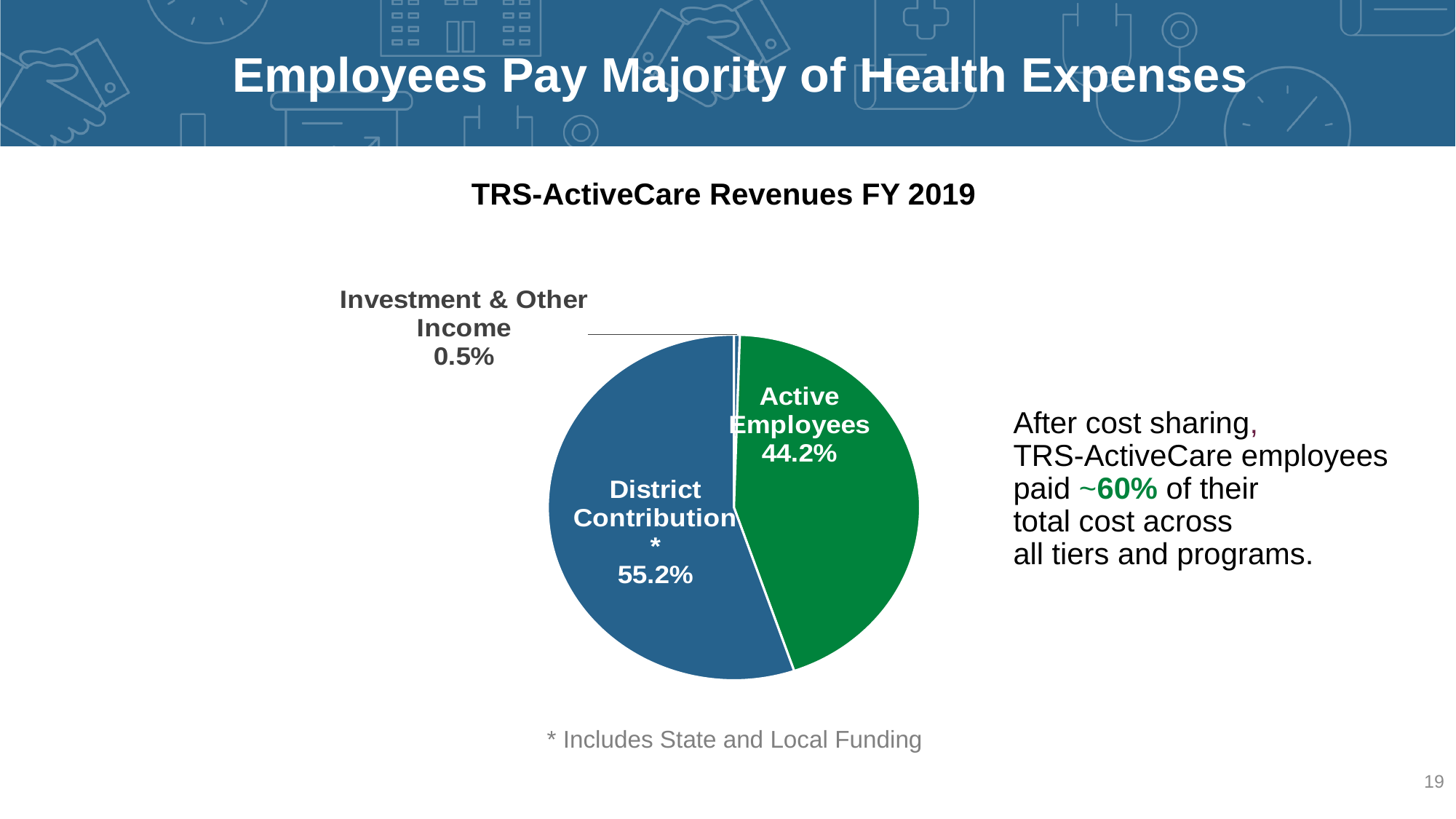
What is the difference in percentage points between the District Contribution and Active Employees slices? 11 percentage points What share of TRS-ActiveCare Revenues FY 2019 comes from Active Employees? 44.2% What share of TRS-ActiveCare Revenues FY 2019 comes from District Contribution? 55.2% How many slices does the pie chart have? 3 What colour is the Active Employees slice? Green What is the combined share of the District Contribution and Investment & Other Income slices? 55.7% What is the title of the chart? TRS-ActiveCare Revenues FY 2019 What kind of chart is shown on the slide? Pie chart Which is larger, the Active Employees slice or the District Contribution slice? District Contribution Which slice of the pie chart is the largest? District Contribution What share of TRS-ActiveCare Revenues FY 2019 comes from Investment & Other Income? 0.5% Which slice of the pie chart is the smallest? Investment & Other Income